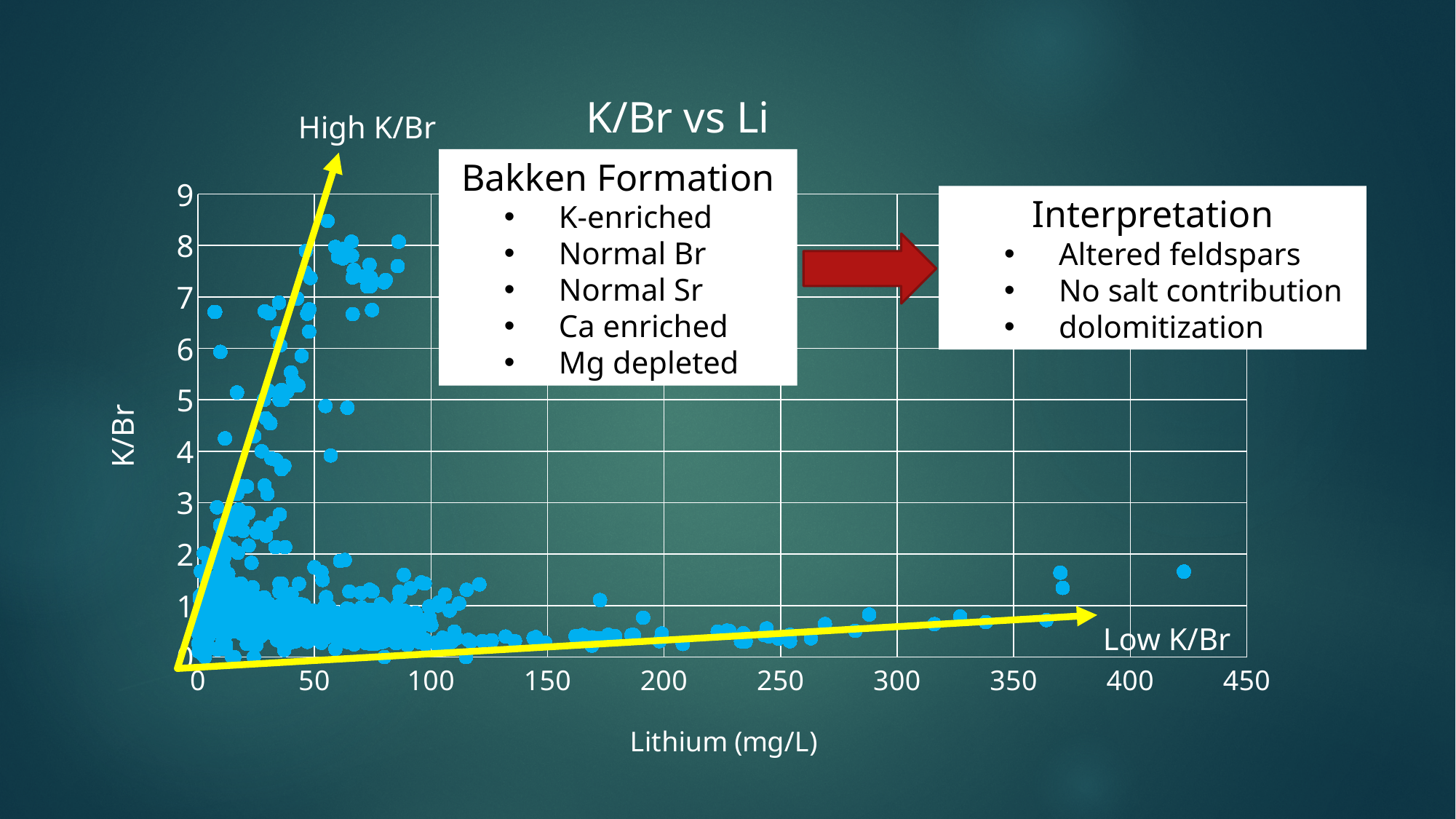
What kind of chart is shown on the slide? scatter plot Is the K/Br value of the highest point on the chart greater or less than 8? greater Is the K/Br value of the rightmost point (near 425 mg/L lithium) greater or less than 2? less Is the K/Br value of the points near 300 mg/L lithium greater or less than 2? less What is the highest value shown on the x axis of the chart? 450 What is the highest value shown on the y axis of the chart? 9 What is the label of the x axis of the chart? Lithium (mg/L) What is the title of the chart? K/Br vs Li